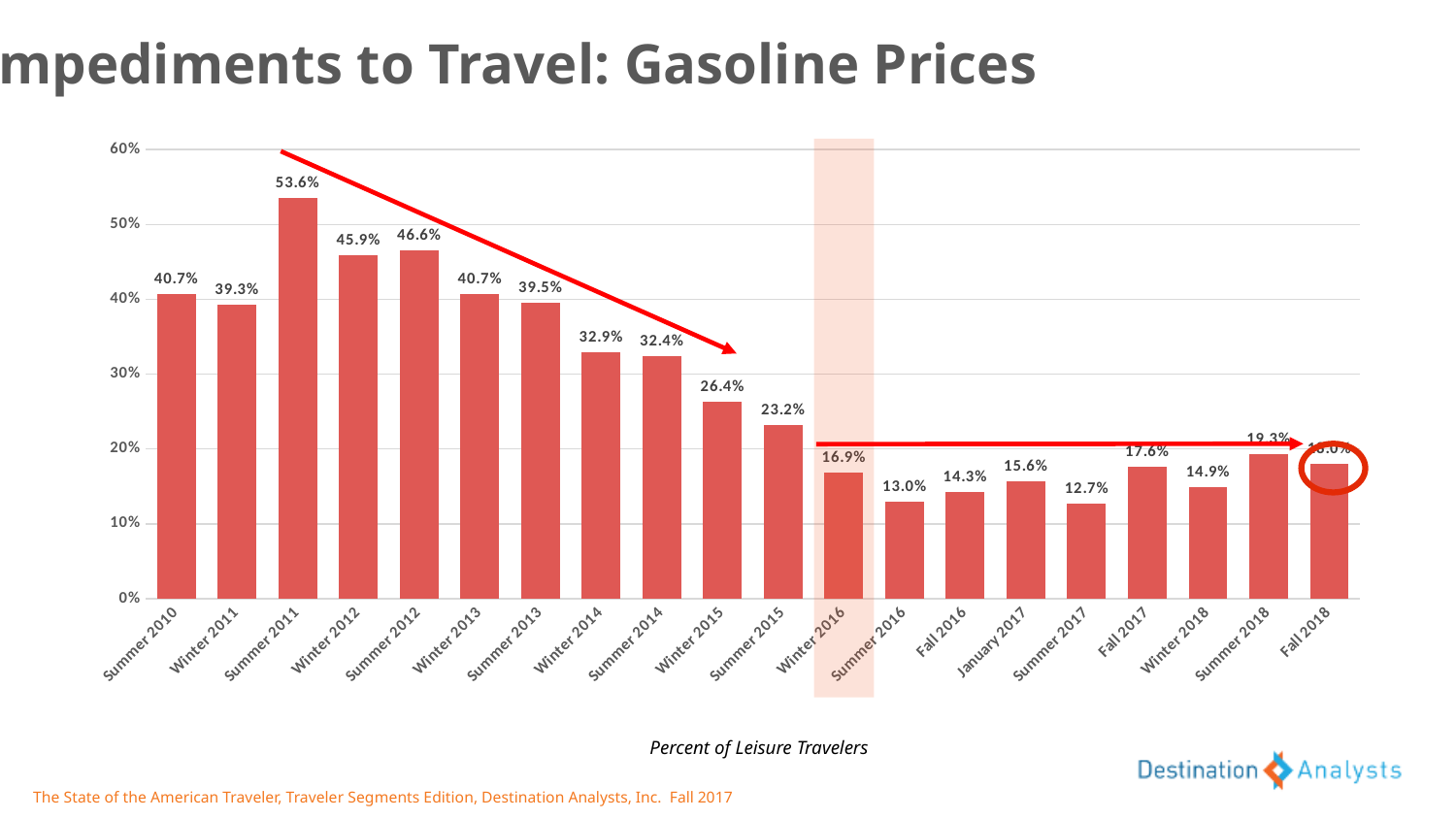
Which period has the lowest value in the chart? Summer 2017 What type of chart is shown on the slide? bar chart What is the value shown for Fall 2017? 17.6% Do the values generally rise or fall from Summer 2011 to Summer 2016? fall What is the value shown for Winter 2016? 16.9% How many periods (bars) are shown in the chart? 20 What is the difference between the values for Summer 2011 and Summer 2017? 40.9% Which is larger, the value for Winter 2012 or the value for Summer 2012? Summer 2012 What percentage of leisure travelers cited gasoline prices as an impediment in Summer 2011? 53.6% Is the value for Summer 2014 greater or less than 30%? greater What is the difference between the values for Winter 2015 and Summer 2015? 3.2% Which period has the highest value in the chart? Summer 2011